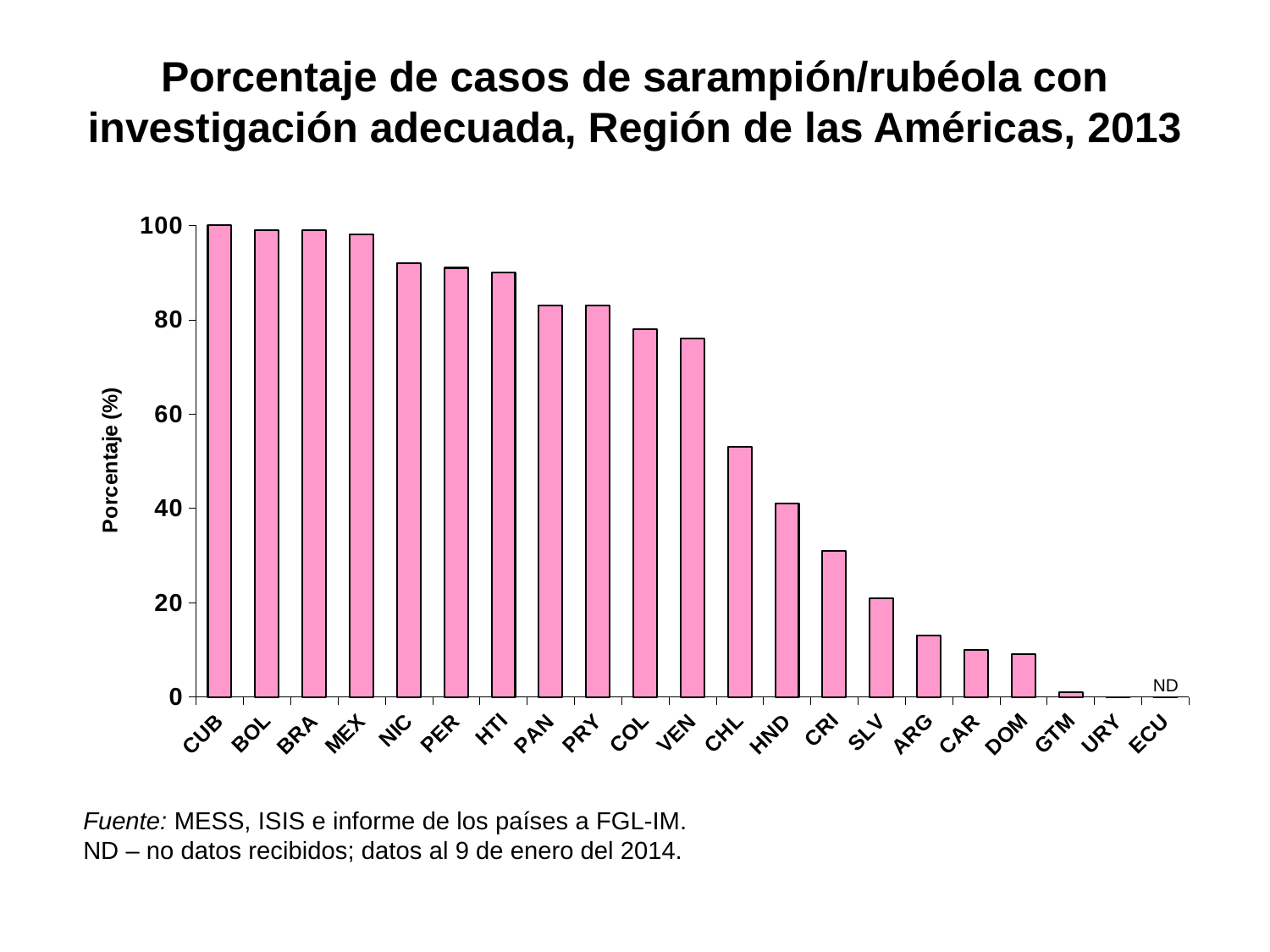
Which has the larger value, CRI or SLV? CRI What is the value for CUB in the chart? 100 Is the value for CRI greater or less than 40? less Is the value for CHL greater or less than 60? less Do the values rise or fall moving from left to right along the x axis? fall Is the value for COL greater or less than 60? greater What type of chart is shown on the slide? Bar chart How many countries/categories are shown on the x axis of the chart? 21 Which has the larger value, CHL or HND? CHL What label is shown above the ECU position instead of a bar? ND